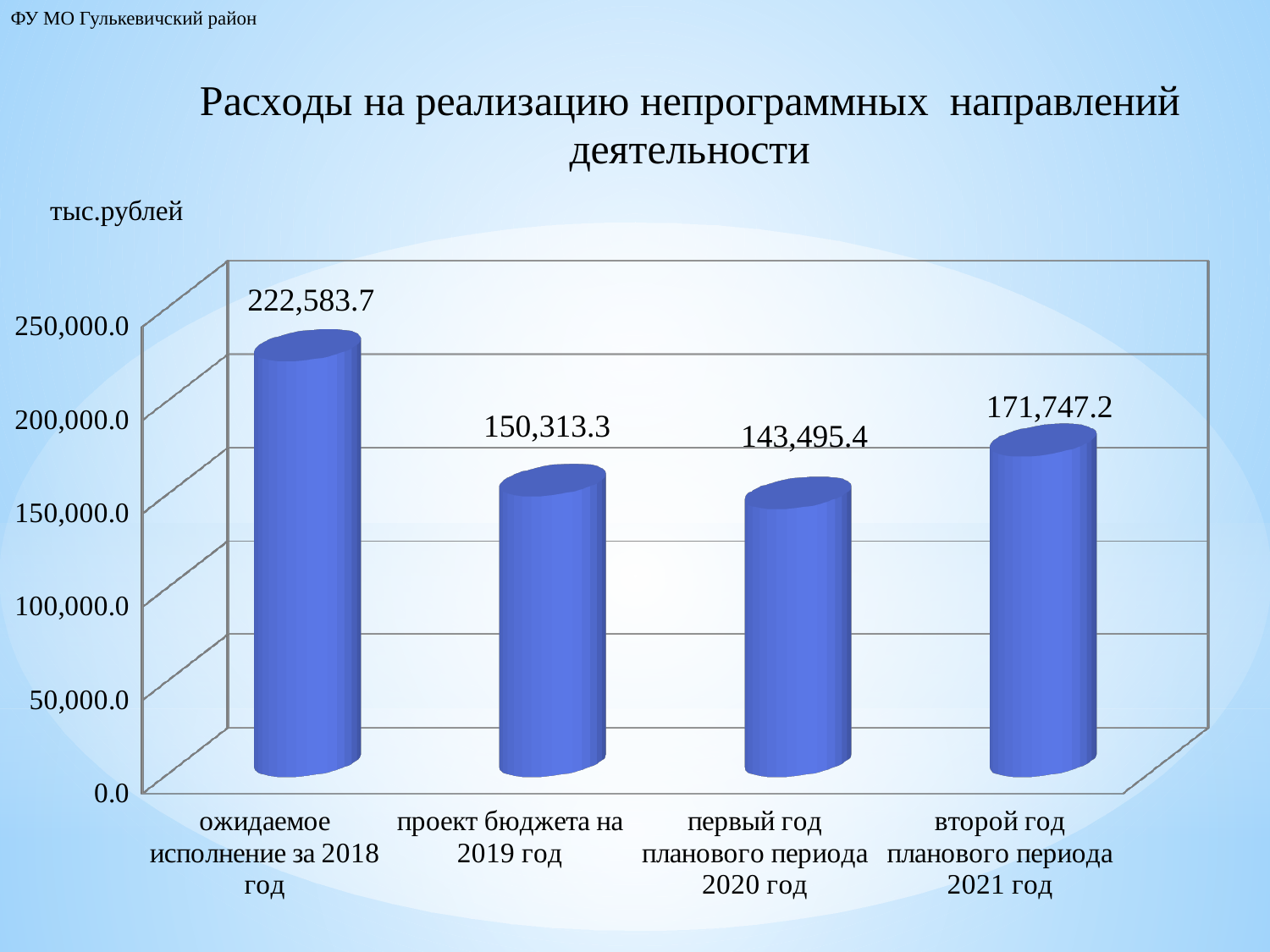
What is the value for 'второй год планового периода 2021 год'? 171,747.2 How many categories are shown on the chart? 4 What is the value for 'ожидаемое исполнение за 2018 год'? 222,583.7 Which category has the lowest value? первый год планового периода 2020 год What is the difference between the values for 2021 and 2020? 28,251.8 Is the value for 'ожидаемое исполнение за 2018 год' greater or less than 200,000.0? greater What is the difference between the values for 2018 and 2019? 72,270.4 Which is larger, the value for 2021 or the value for 2019? 2021 Which category has the highest value? ожидаемое исполнение за 2018 год What kind of chart is shown on the slide? bar chart What is the value for 'первый год планового периода 2020 год'? 143,495.4 What is the value for 'проект бюджета на 2019 год'? 150,313.3